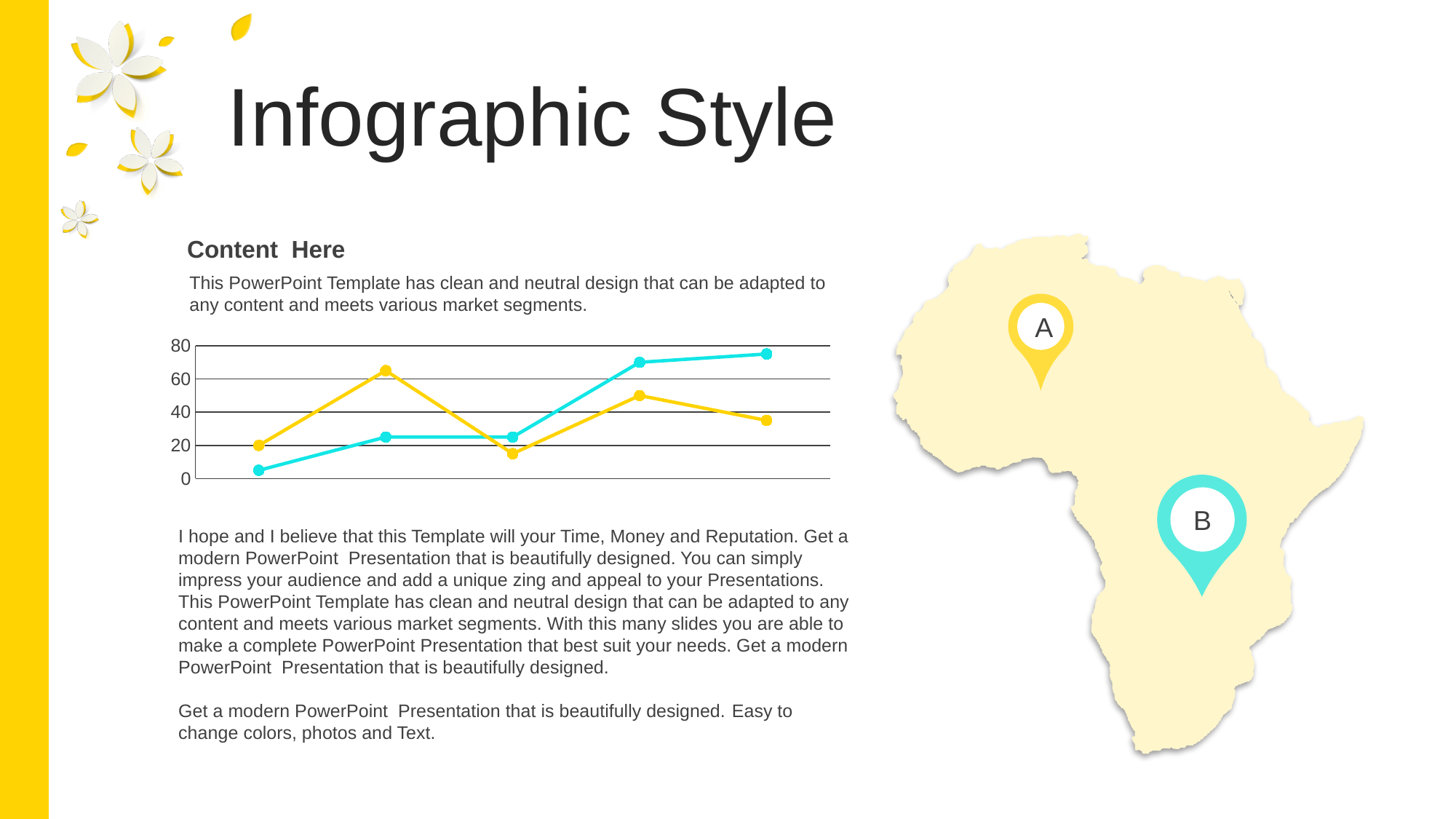
Is the value of the third point on the yellow line greater or less than 20? less At the second data point, which line is higher, the yellow line or the cyan line? yellow line What is the value of the first point on the yellow line? 20 Is the value of the first point on the cyan line greater or less than 20? less Is the value of the second point on the yellow line greater or less than 60? greater Which data point on the yellow line has the lowest value? the third point How many data points does each line on the chart have? 5 What kind of chart is shown on the slide? line chart What is the highest value shown on the chart's vertical axis? 80 How many lines are plotted on the chart? 2 At the fourth data point, which line is higher, the yellow line or the cyan line? cyan line